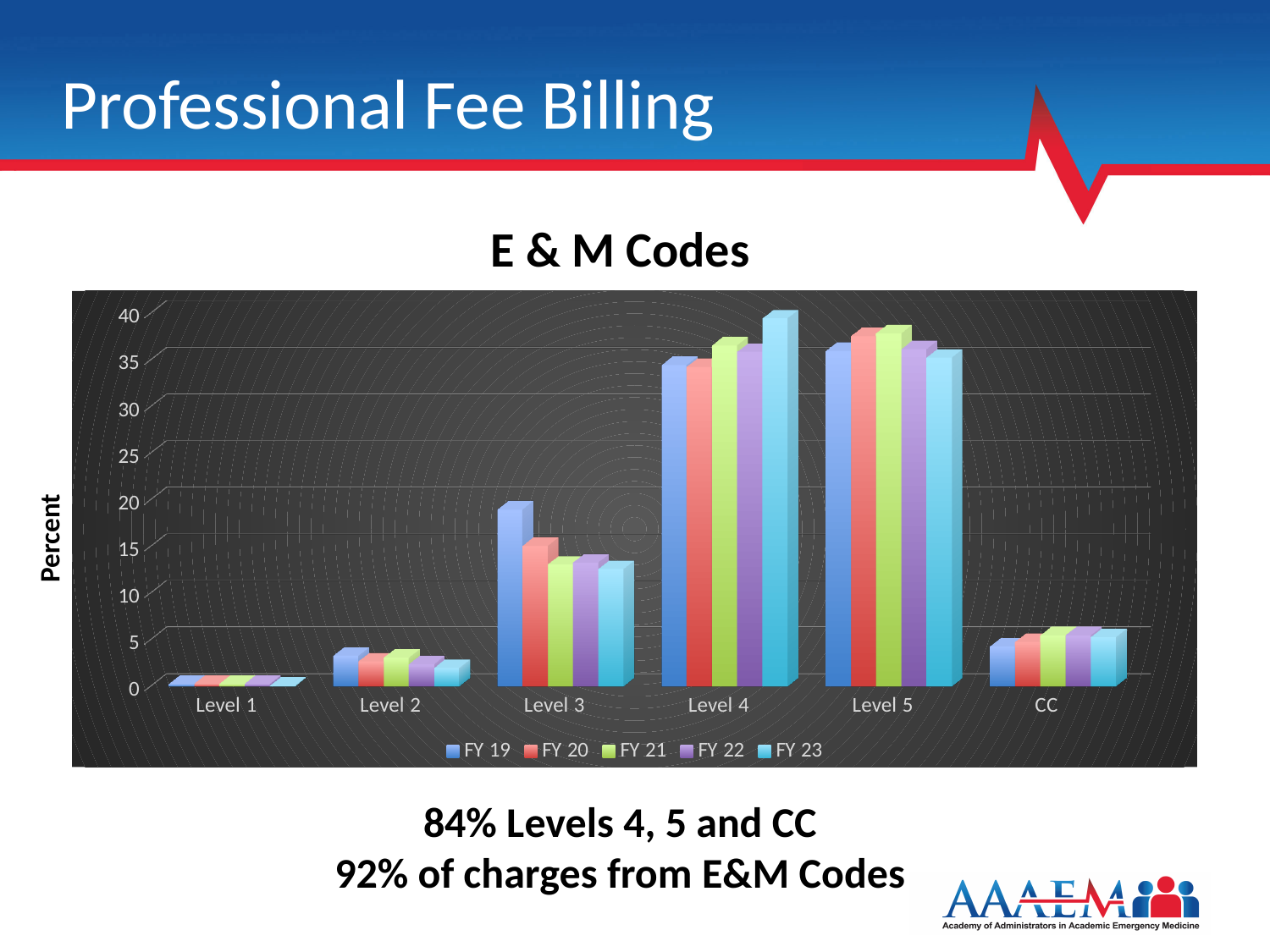
Which category has the lowest values across all fiscal years? Level 1 What kind of chart is shown on the slide? bar chart Is the FY 23 value for Level 4 greater or less than 35? greater For FY 23, which category has the highest value? Level 4 Is the FY 19 value for Level 4 greater or less than 30? greater Is the FY 19 value for Level 2 greater or less than 5? less What is the title of the chart? E & M Codes How many categories are shown on the x axis of the chart? 6 What is the label on the vertical axis of the chart? Percent How many series does the chart legend list? 5 For Level 3, which is larger: the FY 19 value or the FY 23 value? FY 19